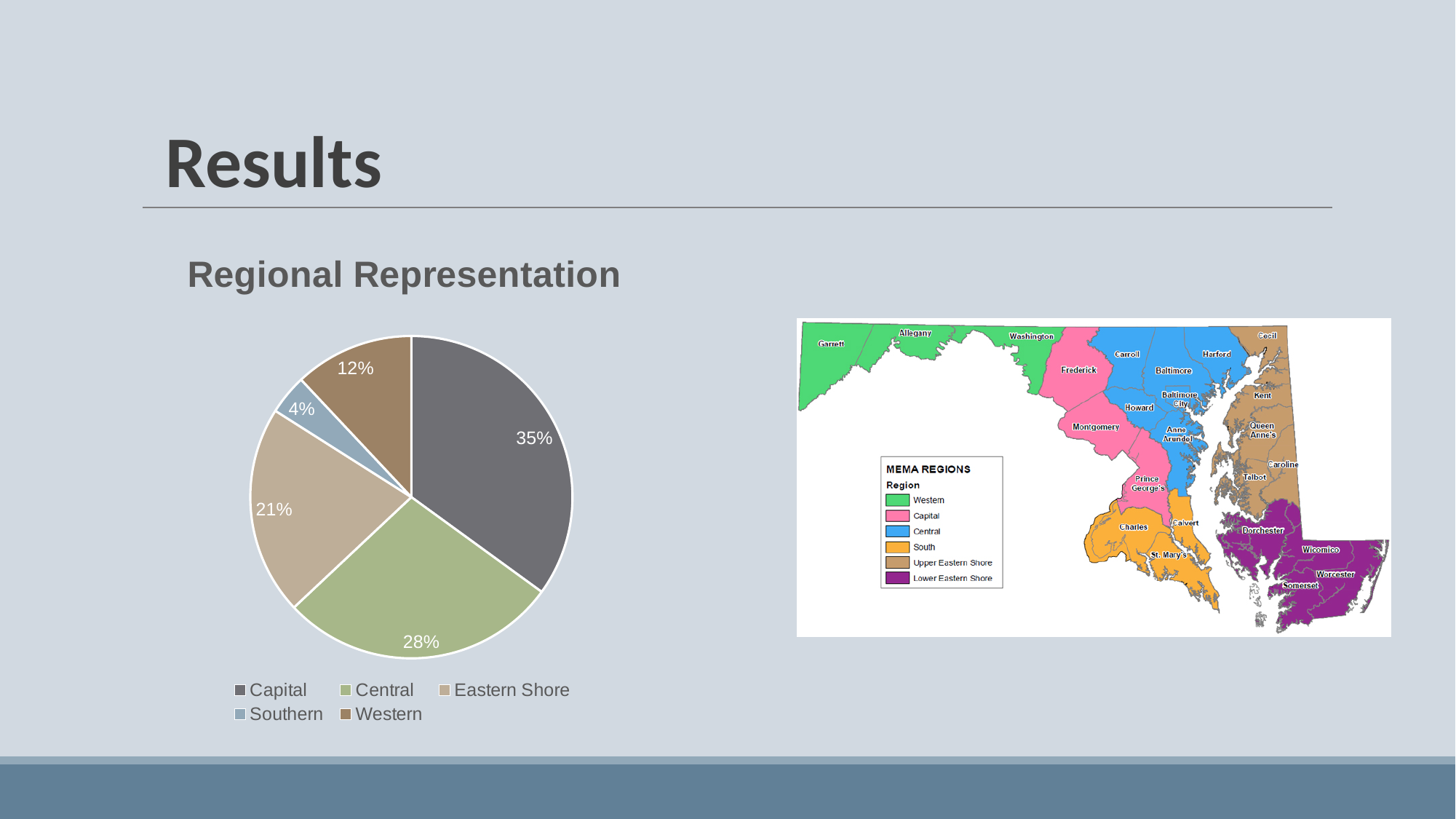
What share of the pie does Southern represent? 4% What is the title of the chart? Regional Representation What share of the pie does Western represent? 12% What share of the pie does Eastern Shore represent? 21% Which region has the largest share of the pie? Capital What share of the pie does Capital represent? 35% What kind of chart is shown on the slide? Pie chart Which is larger, the share for Eastern Shore or the share for Western? Eastern Shore What is the difference in percentage points between Capital and Central? 7 What share of the pie does Central represent? 28% How many regions are shown in the pie chart? 5 Which region has the smallest share of the pie? Southern